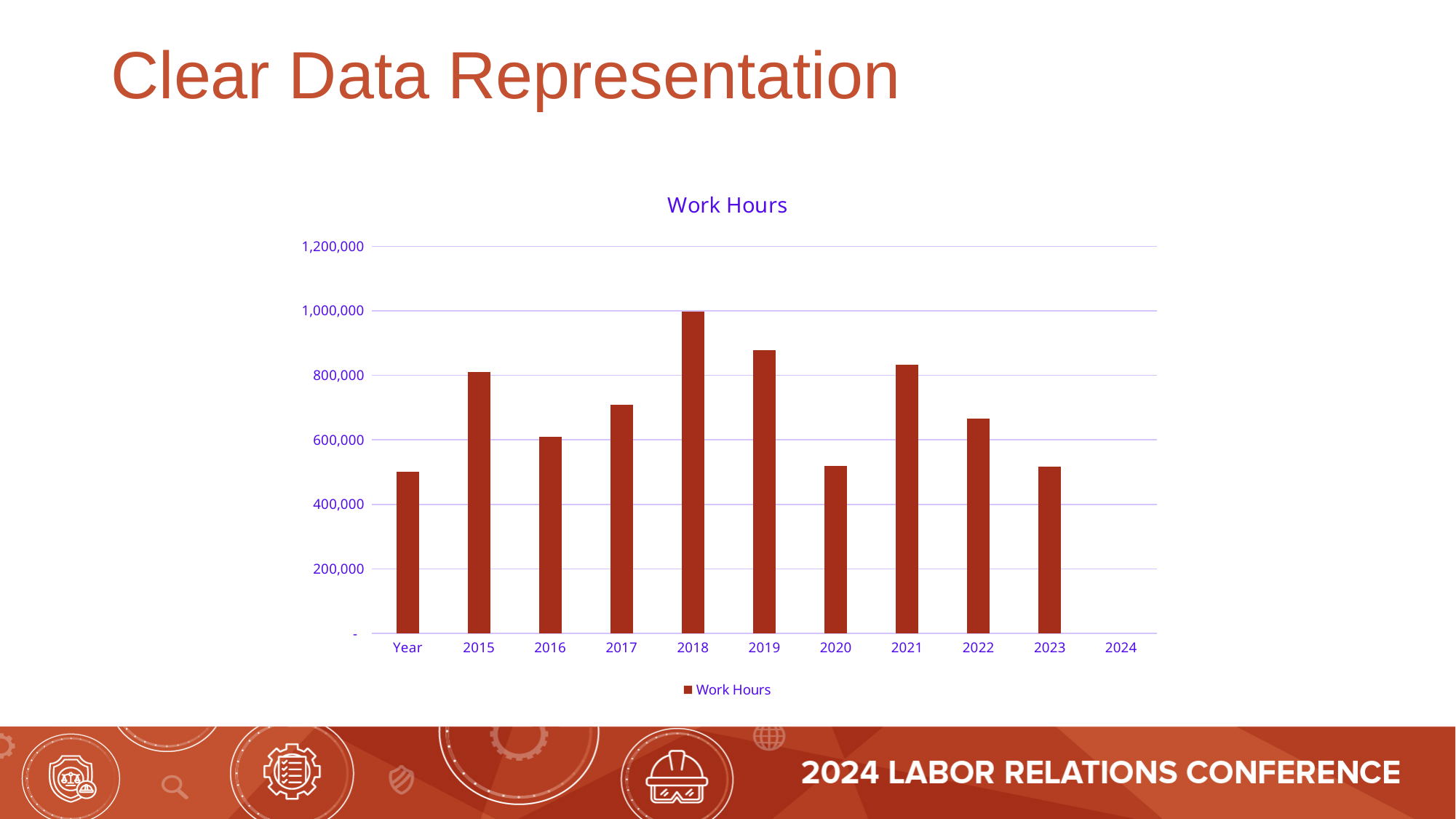
Which is larger, the value for 2015 or the value for 2016? 2015 Is the value for 2018 greater or less than 800,000? greater Is the value for 2016 greater or less than 800,000? less What kind of chart is shown on the slide? bar chart Is the value for 2023 greater or less than 600,000? less Do the values rise or fall from 2016 to 2018? rise Which year has the highest Work Hours value? 2018 How many bars are plotted in the chart? 10 What is the title of the chart? Work Hours How many series does the legend list? 1 Which is larger, the value for 2019 or the value for 2021? 2019